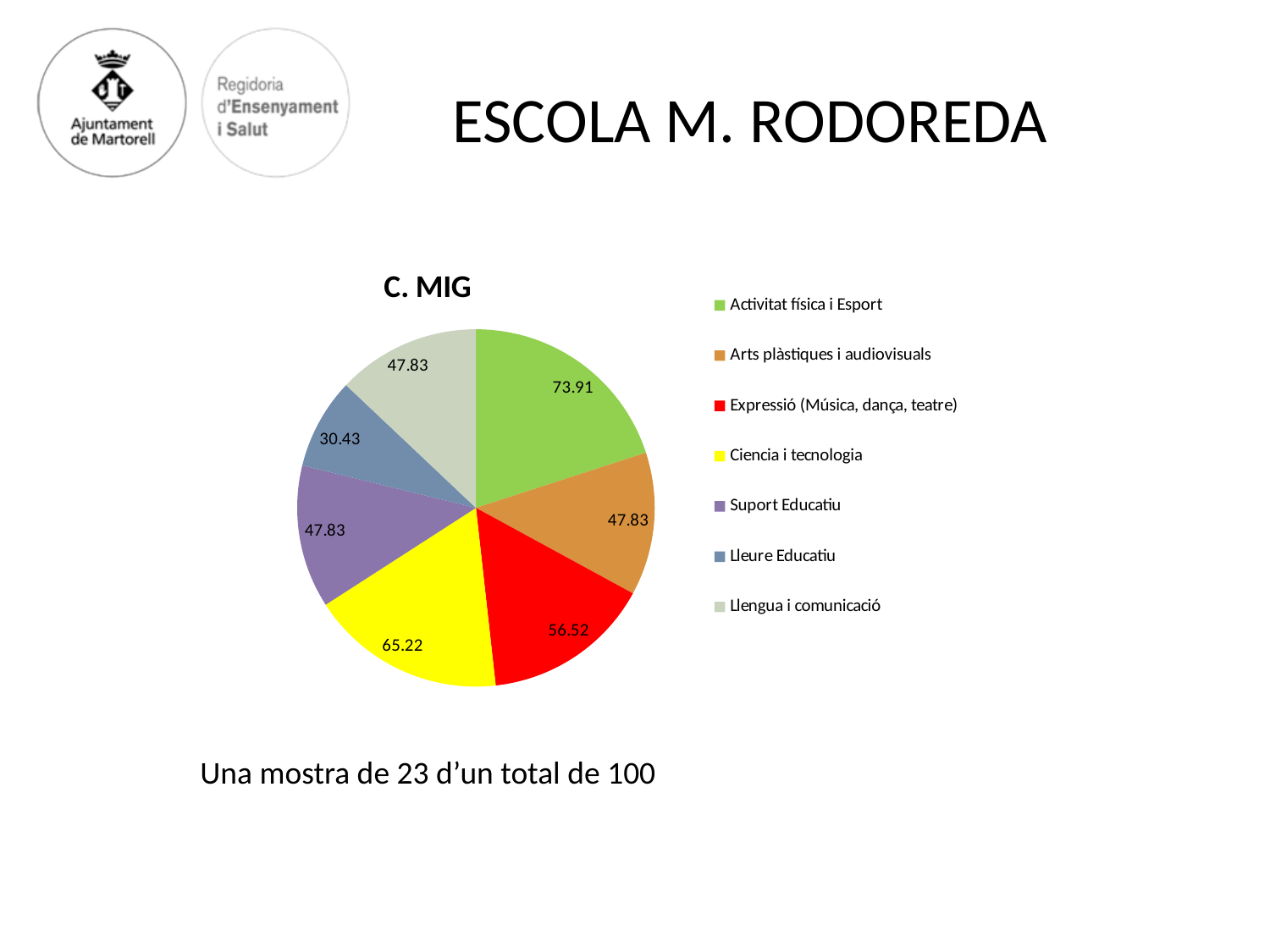
Which category has the smallest slice in the C. MIG pie chart? Lleure Educatiu What is the value shown for Activitat física i Esport in the C. MIG pie chart? 73.91 What is the value shown for Ciencia i tecnologia in the C. MIG pie chart? 65.22 What is the title of the chart on the slide? C. MIG What is the difference between the values for Ciencia i tecnologia and Expressió (Música, dança, teatre) in the C. MIG pie chart? 8.70 Which has a larger value in the C. MIG pie chart, Ciencia i tecnologia or Expressió (Música, dança, teatre)? Ciencia i tecnologia What is the difference between the values for Activitat física i Esport and Lleure Educatiu in the C. MIG pie chart? 43.48 What is the value shown for Expressió (Música, dança, teatre) in the C. MIG pie chart? 56.52 What is the value shown for Lleure Educatiu in the C. MIG pie chart? 30.43 How many slices does the C. MIG pie chart have? 7 Which category has the largest slice in the C. MIG pie chart? Activitat física i Esport What kind of chart is shown on the slide? Pie chart